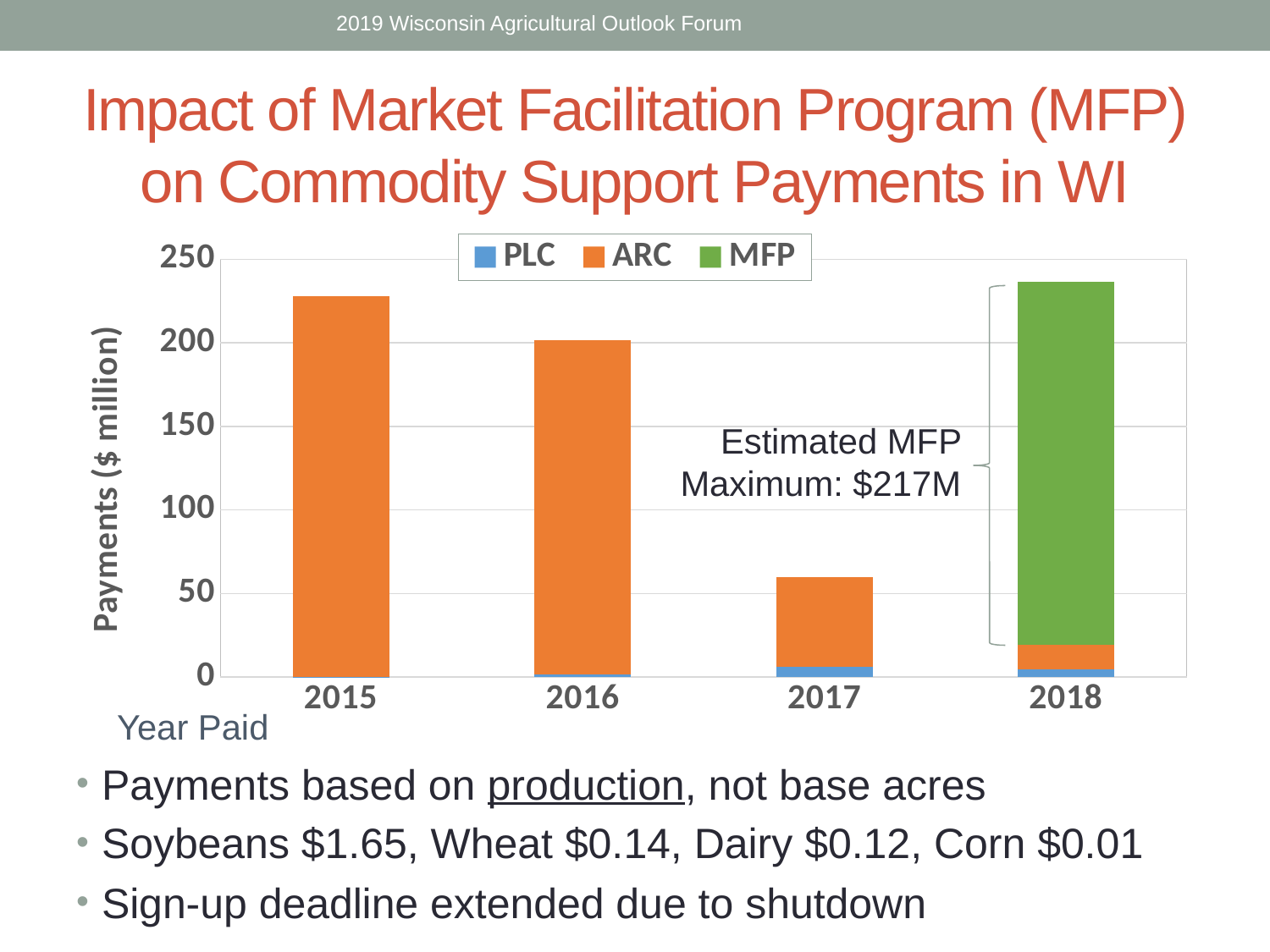
According to the annotation on the chart, what is the estimated MFP maximum? $217M In which year does the MFP series appear in the chart? 2018 What kind of chart is shown on the slide? bar chart Is the total payment for 2015 greater or less than 200? greater What is the label of the y axis of the chart? Payments ($ million) How many series does the chart legend list? 3 Which year has the lowest total payments in the chart? 2017 How many years are shown on the x axis of the chart? 4 Is the total payment for 2017 greater or less than 50? greater Is the total payment for 2018 greater or less than 200? greater Which year has larger total payments, 2015 or 2016? 2015 Which year has the highest total payments in the chart? 2018